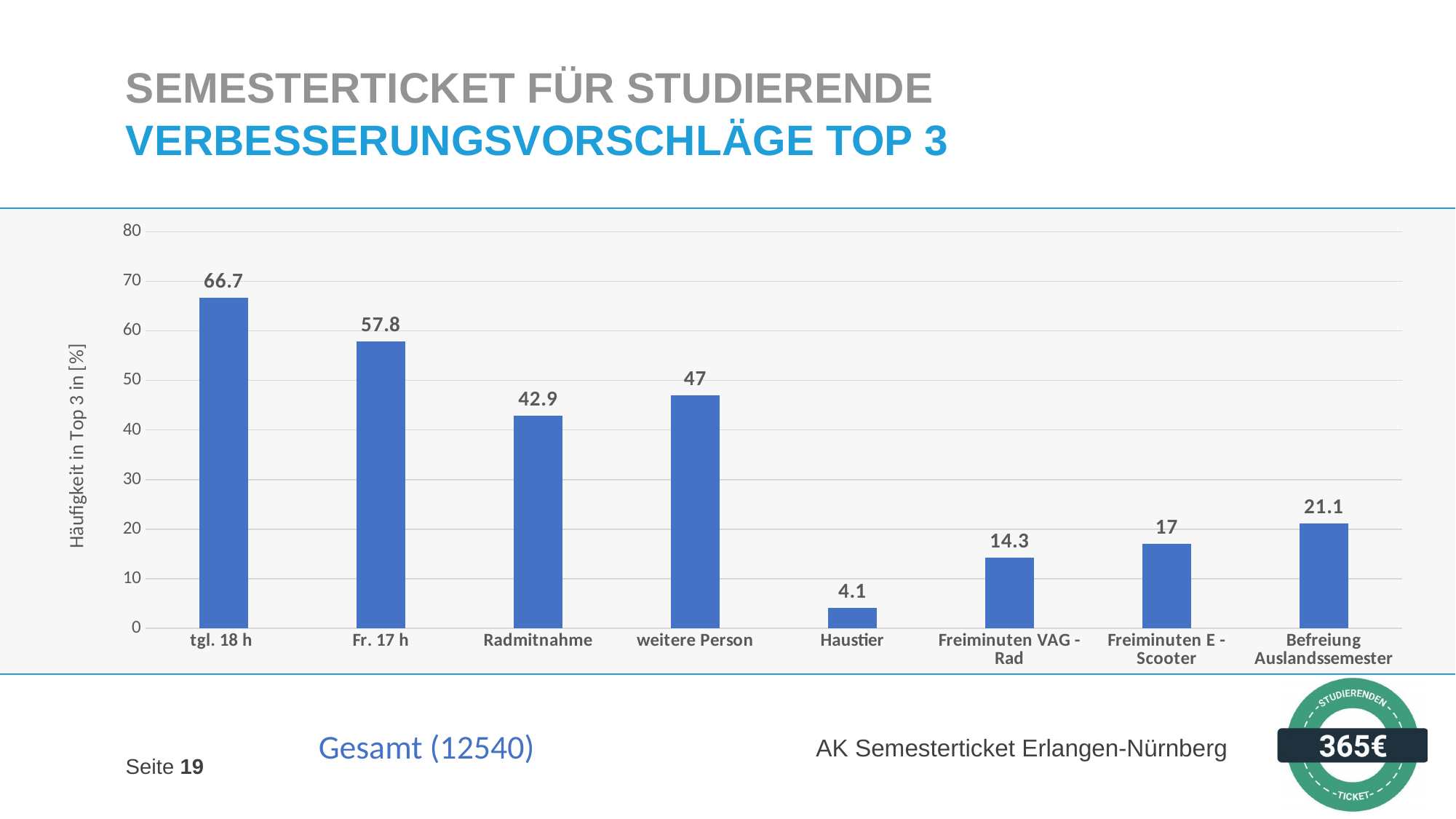
Which category has the highest value? tgl. 18 h Which category has the lowest value? Haustier What is the label of the y axis? Häufigkeit in Top 3 in [%] What is the value for "Befreiung Auslandssemester"? 21.1 What is the value for "Radmitnahme"? 42.9 What is the value for "Haustier"? 4.1 What kind of chart is shown on the slide? bar chart What is the value for "Freiminuten VAG - Rad"? 14.3 What is the difference between the values for "tgl. 18 h" and "Fr. 17 h"? 8.9 How many categories are shown on the x axis? 8 Which is larger, the value for "weitere Person" or the value for "Radmitnahme"? weitere Person Is the value for "Freiminuten E - Scooter" greater or less than 20? less